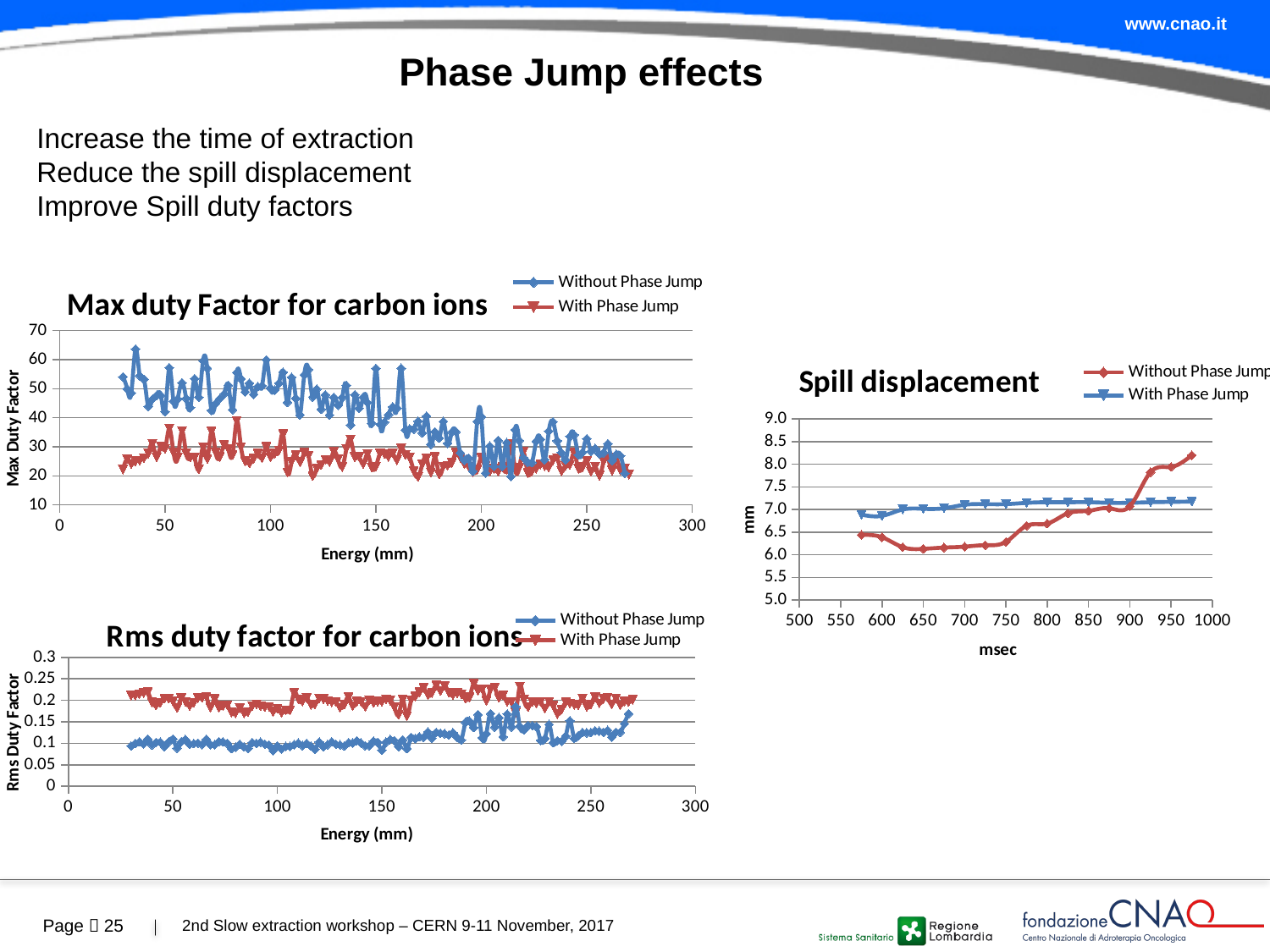
In the 'Rms duty factor for carbon ions' chart, at Energy 100, which series has the larger value: Without Phase Jump or With Phase Jump? With Phase Jump In the 'Spill displacement' chart, is the value for Without Phase Jump at 650 msec greater or less than 6.5? less In the 'Max duty Factor for carbon ions' chart, at Energy 50, which series has the larger value: Without Phase Jump or With Phase Jump? Without Phase Jump In the 'Spill displacement' chart, how many series does the legend list? 2 In the 'Max duty Factor for carbon ions' chart, does the Without Phase Jump series generally rise or fall as Energy increases from 50 to 250? fall In the 'Rms duty factor for carbon ions' chart, how many series does the legend list? 2 What kind of chart is the 'Max duty Factor for carbon ions' chart? line chart In the 'Spill displacement' chart, is the value for With Phase Jump at 900 msec greater or less than 6.5? greater In the 'Spill displacement' chart, what is the x-axis label? msec In the 'Rms duty factor for carbon ions' chart, is the value for Without Phase Jump at Energy 100 greater or less than 0.15? less In the 'Max duty Factor for carbon ions' chart, what are the two legend entries? Without Phase Jump and With Phase Jump In the 'Spill displacement' chart, does the Without Phase Jump series rise or fall between 900 and 975 msec? rise